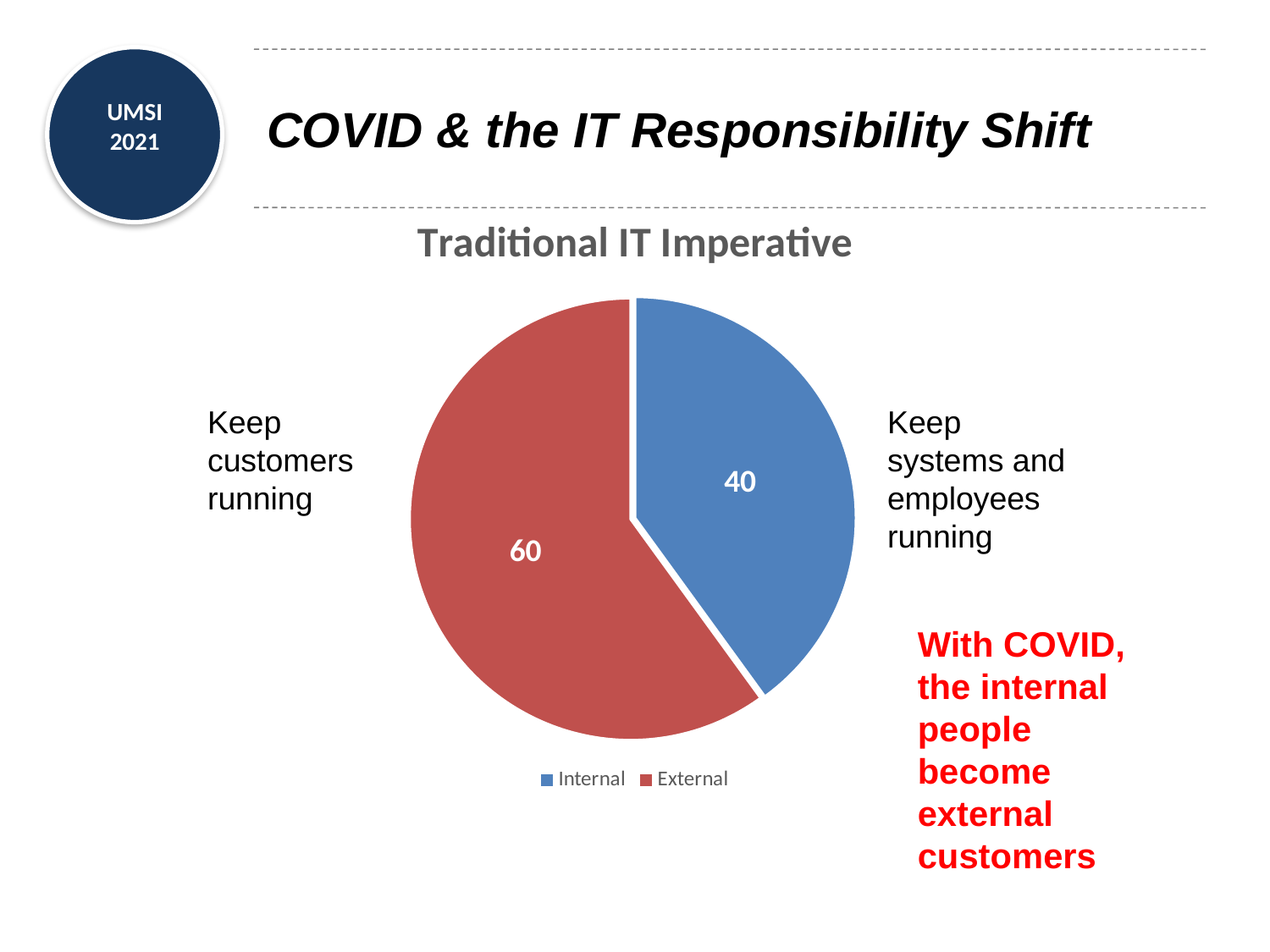
Which is larger in the pie chart, Internal or External? External What is the difference between the External and Internal values in the pie chart? 20 What share of the pie does the Internal slice represent? 40% Which slice of the pie chart is the largest? External What share of the pie does the External slice represent? 60% What colour is the Internal slice in the pie chart? Blue What is the value for Internal in the pie chart? 40 How many slices does the pie chart have? 2 What is the value for External in the pie chart? 60 Which slice of the pie chart is the smallest? Internal What kind of chart is shown on the slide? Pie chart What is the title of the pie chart? Traditional IT Imperative